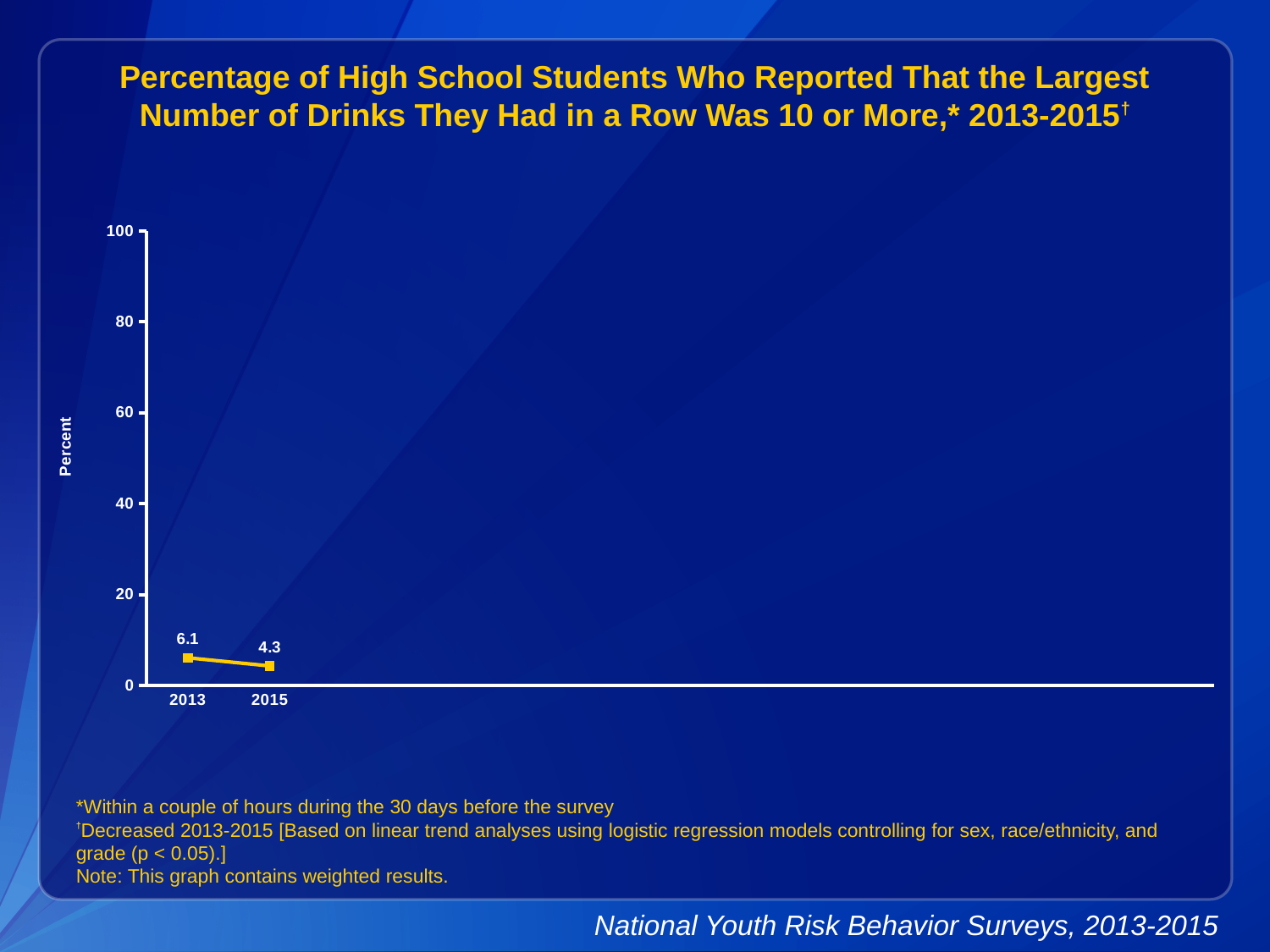
What is the difference between the 2013 and 2015 values? 1.8 Do the values rise or fall from 2013 to 2015? fall What is the maximum value shown on the y axis? 100 Is the value for 2013 greater or less than 20? less Which year has the highest value? 2013 Which year has the lowest value? 2015 What is the value for 2015? 4.3 How many data points are plotted on the chart? 2 What is the label on the y axis? Percent What is the value for 2013? 6.1 What kind of chart is shown on the slide? line chart Which is larger, the value for 2013 or the value for 2015? 2013